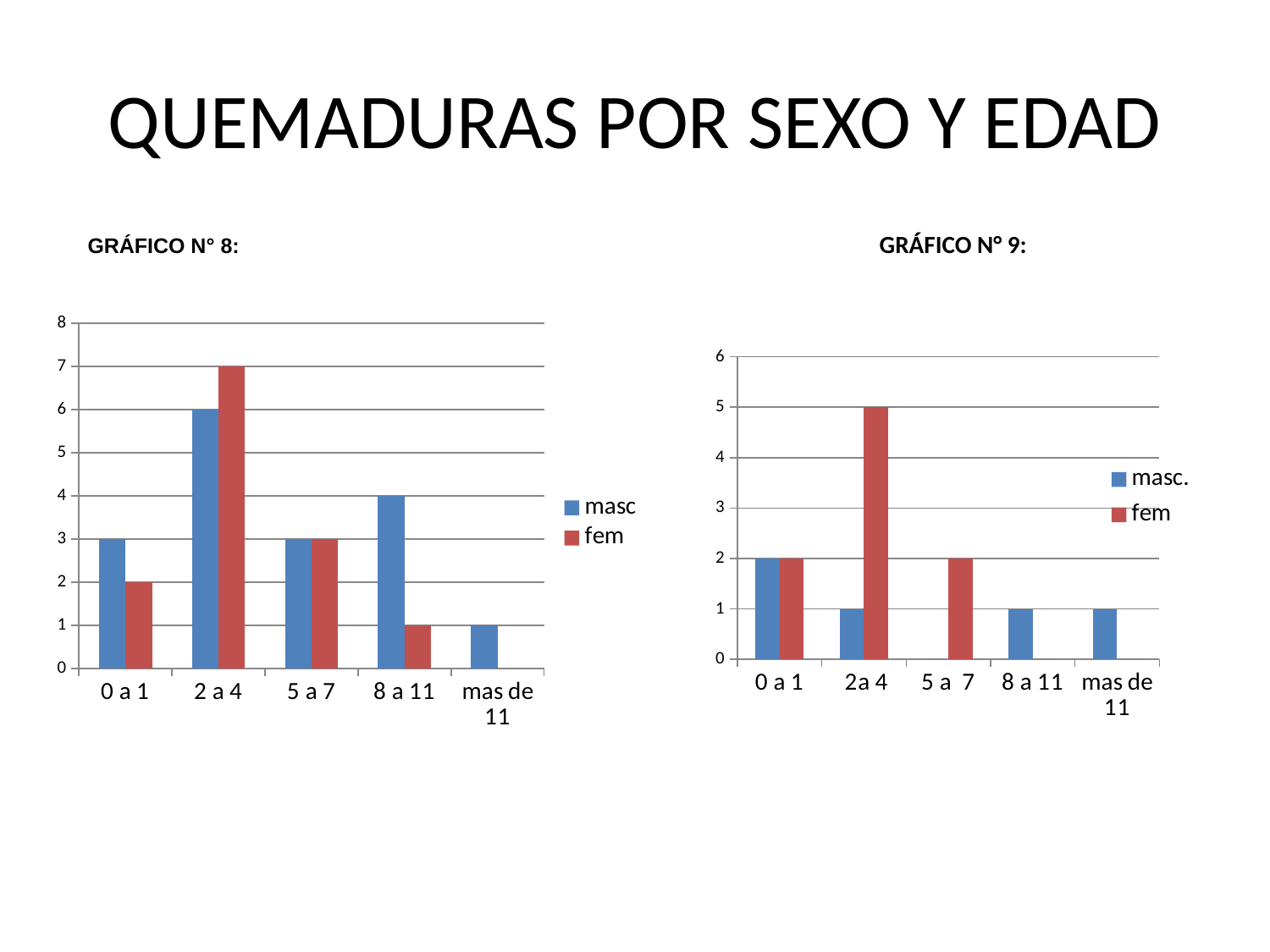
In Gráfico N° 8, what is the value for masc in the 2 a 4 category? 6 In Gráfico N° 9, how many categories are shown on the x axis? 5 In Gráfico N° 8, what is the difference between the fem and masc values in the 0 a 1 category? 1 What kind of chart is Gráfico N° 9? bar chart In Gráfico N° 8, how many series does the legend list? 2 In Gráfico N° 9, what colour represents the fem series? red In Gráfico N° 9, what is the value for masc. in the 0 a 1 category? 2 In Gráfico N° 9, which category has the highest fem value? 2a 4 In Gráfico N° 8, what is the value for fem in the 2 a 4 category? 7 In Gráfico N° 8, which category has the highest masc value? 2 a 4 In Gráfico N° 9, what is the value for fem in the 2a 4 category? 5 In Gráfico N° 8, which is larger in the 8 a 11 category, masc or fem? masc